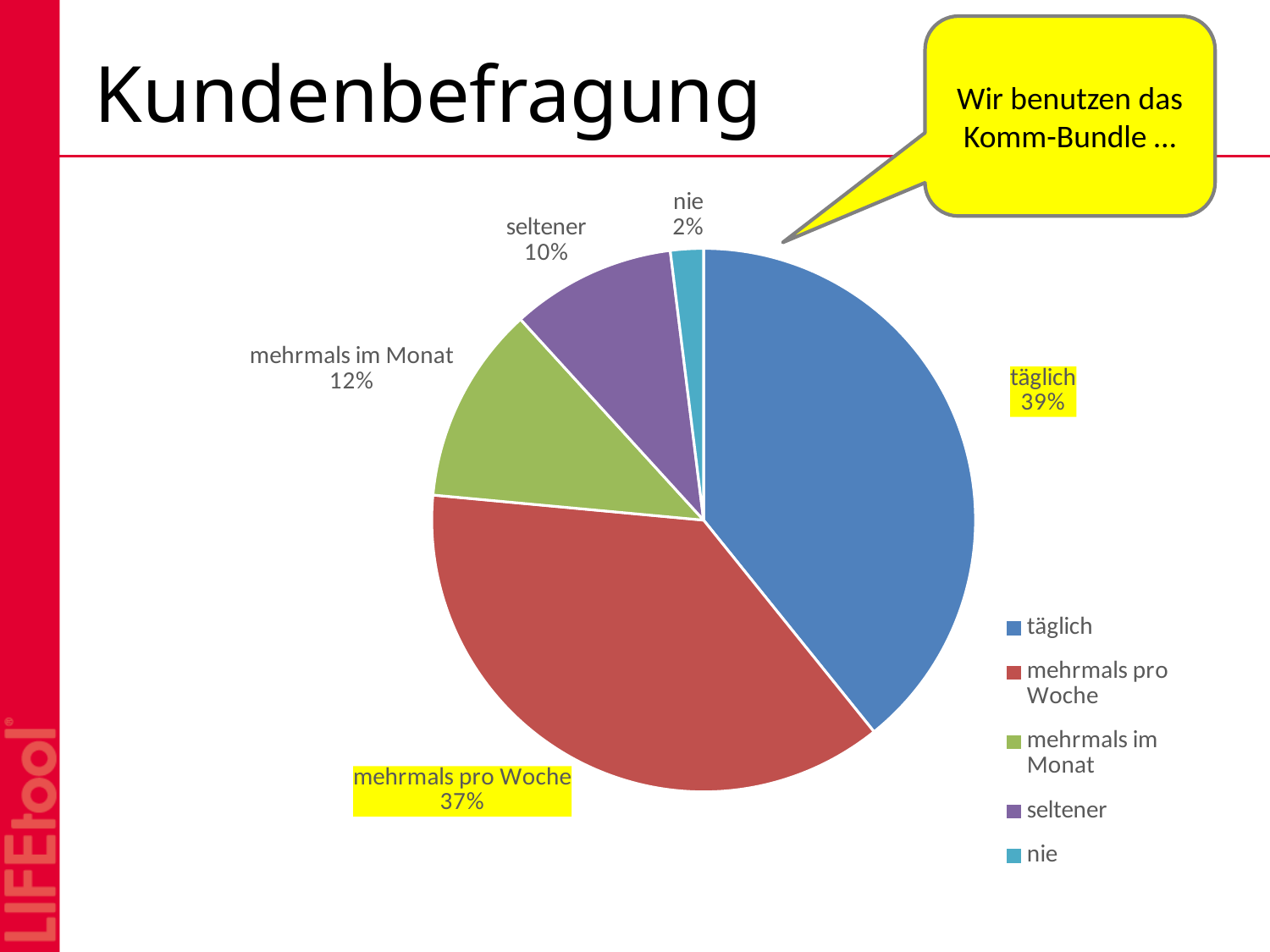
Which two categories are highlighted in yellow on the chart? täglich and mehrmals pro Woche Which is larger, the share for "mehrmals im Monat" or the share for "seltener"? mehrmals im Monat What share of the pie does "täglich" represent? 39% What is the value shown for "nie"? 2% What kind of chart is shown on the slide? pie chart Which category has the smallest slice of the pie? nie What is the value shown for "mehrmals im Monat"? 12% Which category has the largest slice of the pie? täglich What is the value shown for "mehrmals pro Woche"? 37% What is the difference between the shares of "täglich" and "mehrmals pro Woche"? 2% What is the value shown for "seltener"? 10% How many categories does the pie chart show? 5